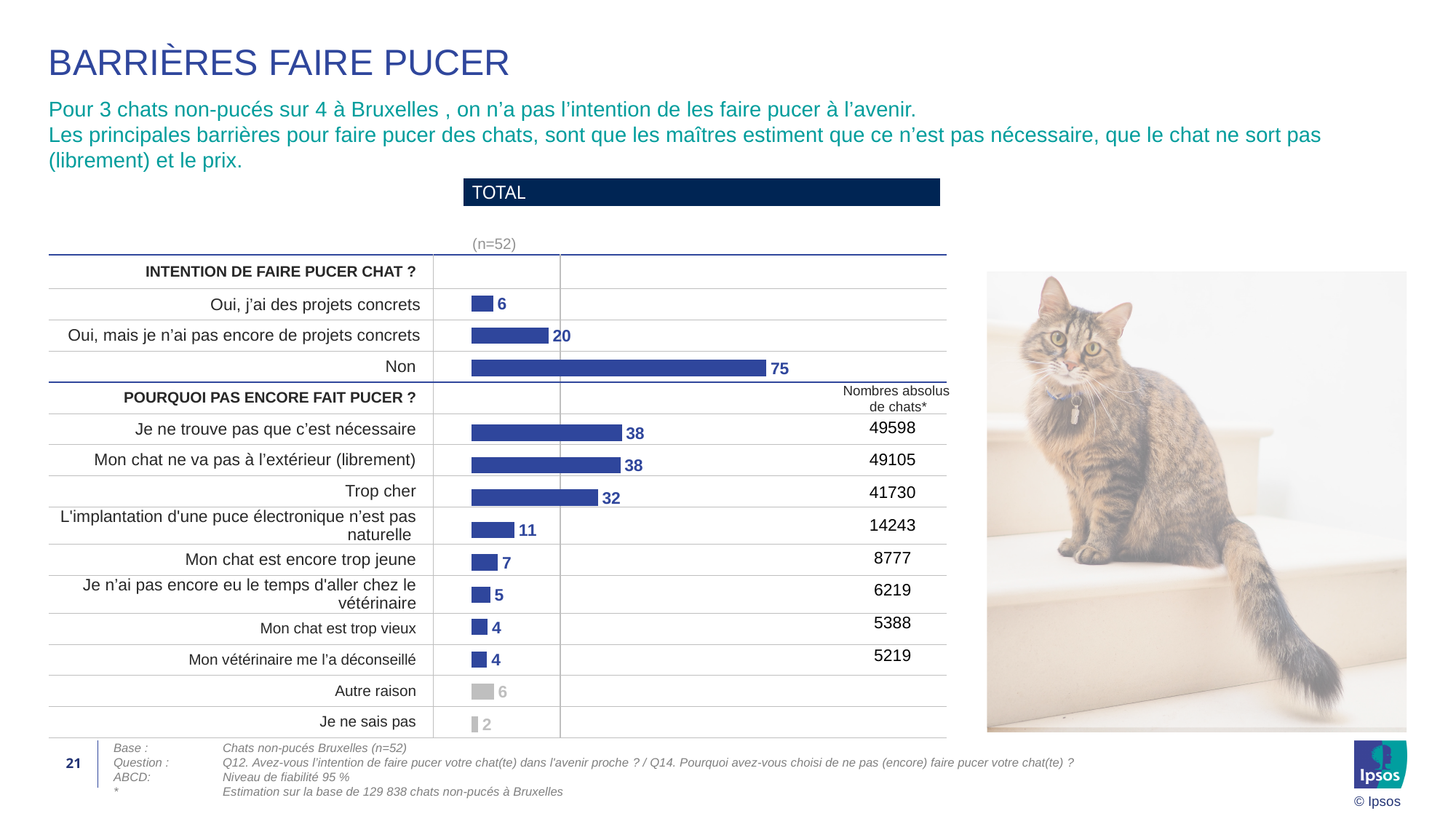
What is the value for "Mon chat est encore trop jeune"? 7 What is the difference between the values for "Trop cher" and "L'implantation d'une puce électronique n'est pas naturelle"? 21 Which answer under "INTENTION DE FAIRE PUCER CHAT ?" has the highest value? Non What type of chart is shown on the slide? Bar chart What is the "Nombres absolus de chats" value for "Je ne trouve pas que c'est nécessaire"? 49598 What is the value for "Oui, mais je n'ai pas encore de projets concrets"? 20 What is the value for "Trop cher"? 32 Which is larger: the value for "Trop cher" or the value for "Mon chat est encore trop jeune"? Trop cher What is the difference between the values for "Non" and "Oui, j'ai des projets concrets"? 69 What is the sample size (n) shown above the chart? n=52 What is the value for "Non" under "INTENTION DE FAIRE PUCER CHAT ?"? 75 Which reason under "POURQUOI PAS ENCORE FAIT PUCER ?" has the lowest value? Je ne sais pas